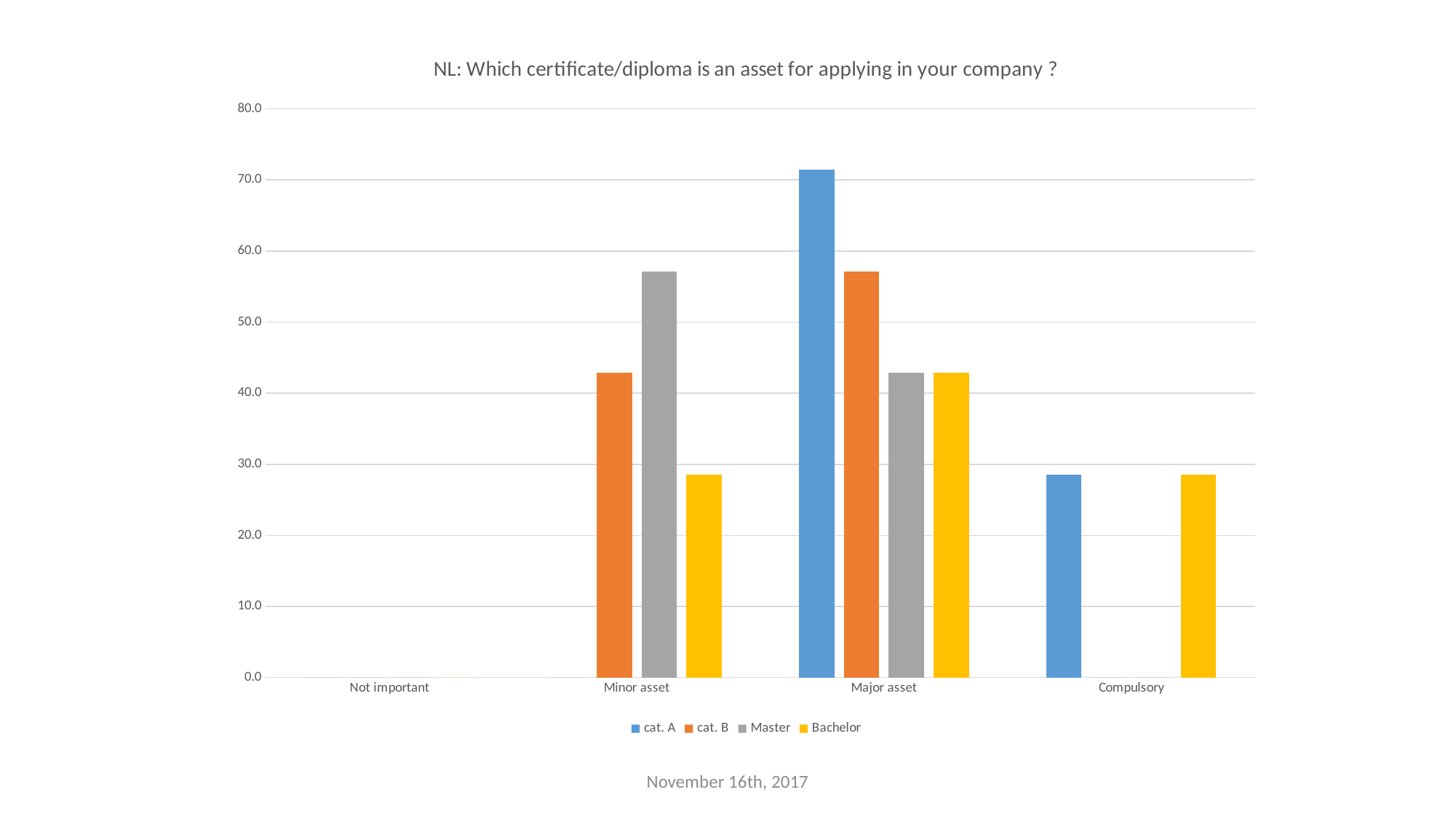
Is the value for Master in the Minor asset category greater or less than 50? greater Is the value for Bachelor in the Minor asset category greater or less than 30? less What colour represents the Bachelor series in the legend? yellow How many series does the legend list? 4 In which category is the cat. A bar the highest? Major asset How many categories are shown on the x axis? 4 Is the value for cat. A in the Major asset category greater or less than 60? greater What kind of chart is shown on the slide? bar chart What is the title of the chart? NL: Which certificate/diploma is an asset for applying in your company ? In the Major asset category, which is larger: the cat. A bar or the cat. B bar? cat. A Which series has the highest bar in the Major asset category? cat. A In the Minor asset category, which is larger: the Master bar or the cat. B bar? Master